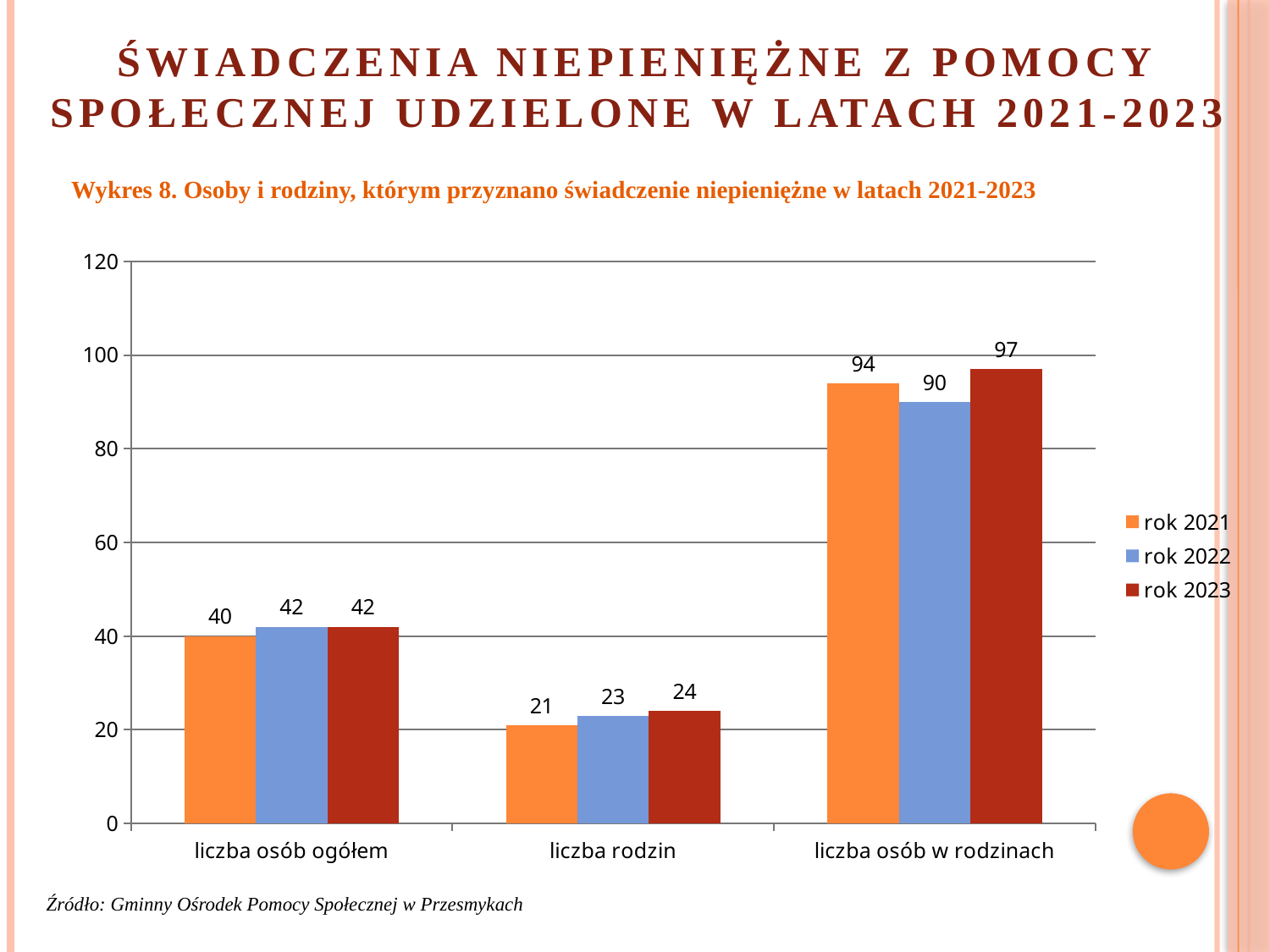
Which category has the highest value in the 'rok 2023' series? liczba osób w rodzinach What is the title of the chart? Wykres 8. Osoby i rodziny, którym przyznano świadczenie niepieniężne w latach 2021-2023 What is the value for 'liczba osób ogółem' in the 'rok 2021' series? 40 What is the difference between the 'rok 2023' and 'rok 2021' values for 'liczba osób w rodzinach'? 3 What is the value for 'liczba rodzin' in the 'rok 2023' series? 24 How many categories are shown on the x axis? 3 Do the values for 'liczba rodzin' rise or fall from 'rok 2021' to 'rok 2023'? rise How many series does the legend list? 3 What is the value for 'liczba osób w rodzinach' in the 'rok 2022' series? 90 What kind of chart is shown on the slide? bar chart Which category has the lowest value in the 'rok 2021' series? liczba rodzin Which is larger for 'liczba osób w rodzinach': the 'rok 2021' value or the 'rok 2022' value? rok 2021